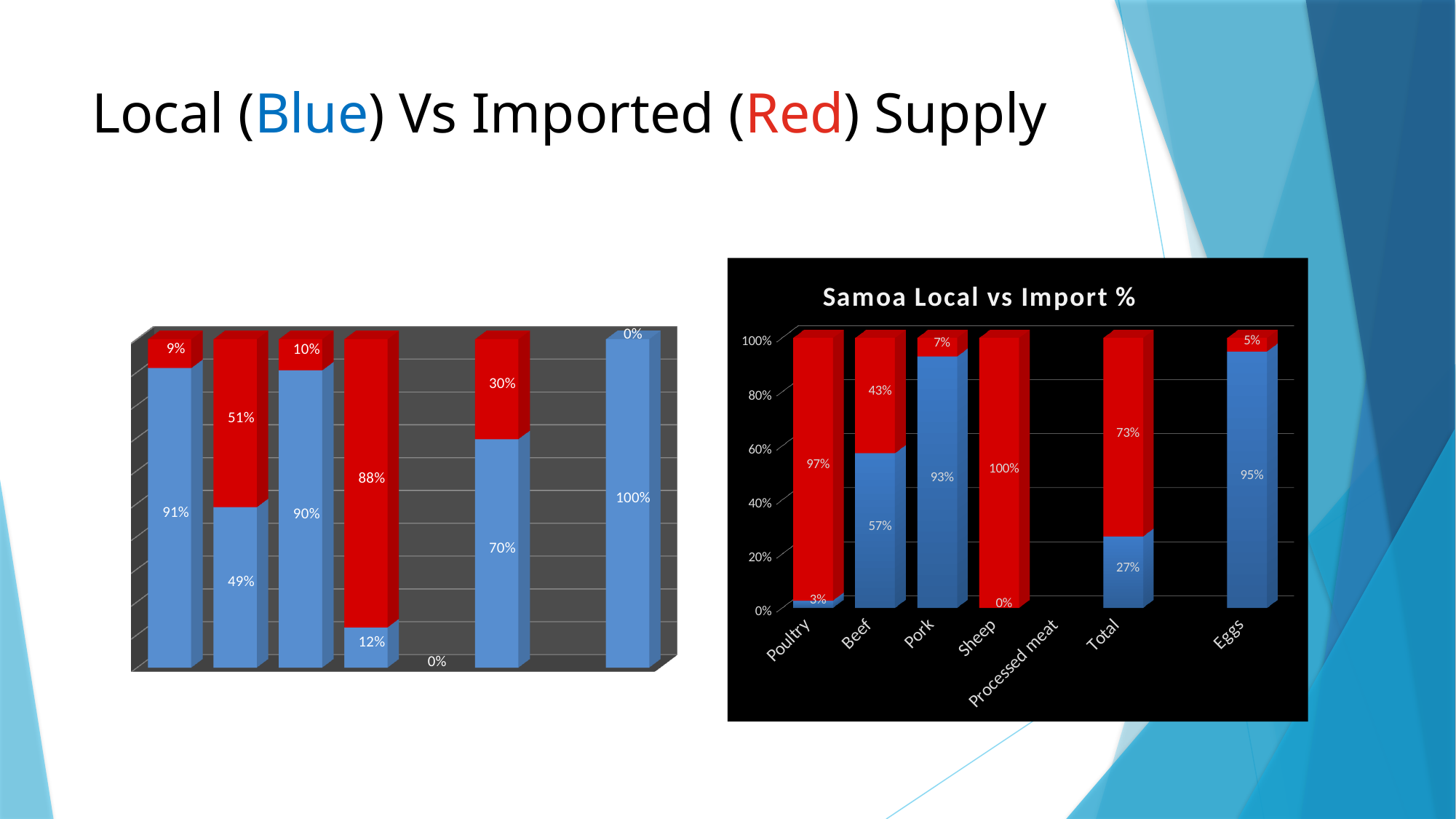
What is the title of the chart on the right side of the slide? Samoa Local vs Import % In the 'Samoa Local vs Import %' chart, what is the imported (red) percentage for Total? 73% In the 'Samoa Local vs Import %' chart, what is the local (blue) percentage for Pork? 93% In the 'Samoa Local vs Import %' chart, which has a larger local (blue) percentage, Pork or Beef? Pork In the 'Samoa Local vs Import %' chart, what is the local (blue) percentage for Beef? 57% In the 'Samoa Local vs Import %' chart, is the local (blue) value for Total greater or less than 40%? less How many category labels are shown on the x axis of the 'Samoa Local vs Import %' chart? 7 In the 'Samoa Local vs Import %' chart, what is the imported (red) percentage for Poultry? 97% In the 'Samoa Local vs Import %' chart, what is the difference between the local and imported percentages for Beef? 14% In the 'Samoa Local vs Import %' chart, which category has a local (blue) percentage of 0%? Sheep In the 'Samoa Local vs Import %' chart, which category has the highest local (blue) percentage? Eggs What kind of chart is the 'Samoa Local vs Import %' chart? Stacked bar chart